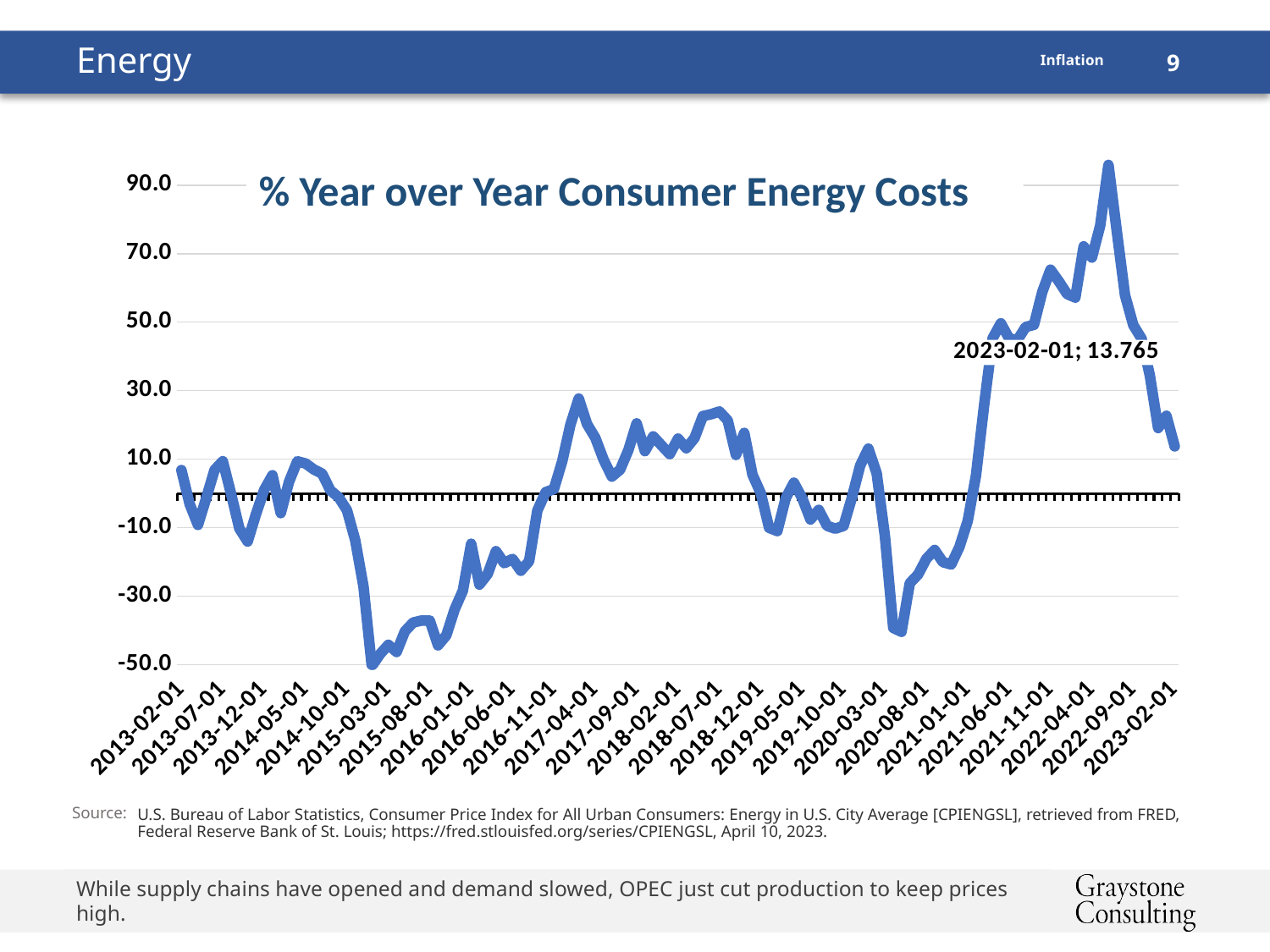
Is the value for 2020-08-01 greater or less than -10.0? less Is the value for 2022-04-01 greater or less than 50.0? greater Is the value for 2019-05-01 greater or less than 10.0? less What kind of chart is shown on the slide? line chart What is the value labelled on the chart for 2023-02-01? 13.765 What is the title of the chart? % Year over Year Consumer Energy Costs Between 2020-08-01 and 2021-06-01, does the line rise or fall? rise How many date labels are shown on the x axis? 25 What is the highest value shown on the y axis? 90.0 Between 2022-04-01 and 2023-02-01, does the line rise or fall? fall